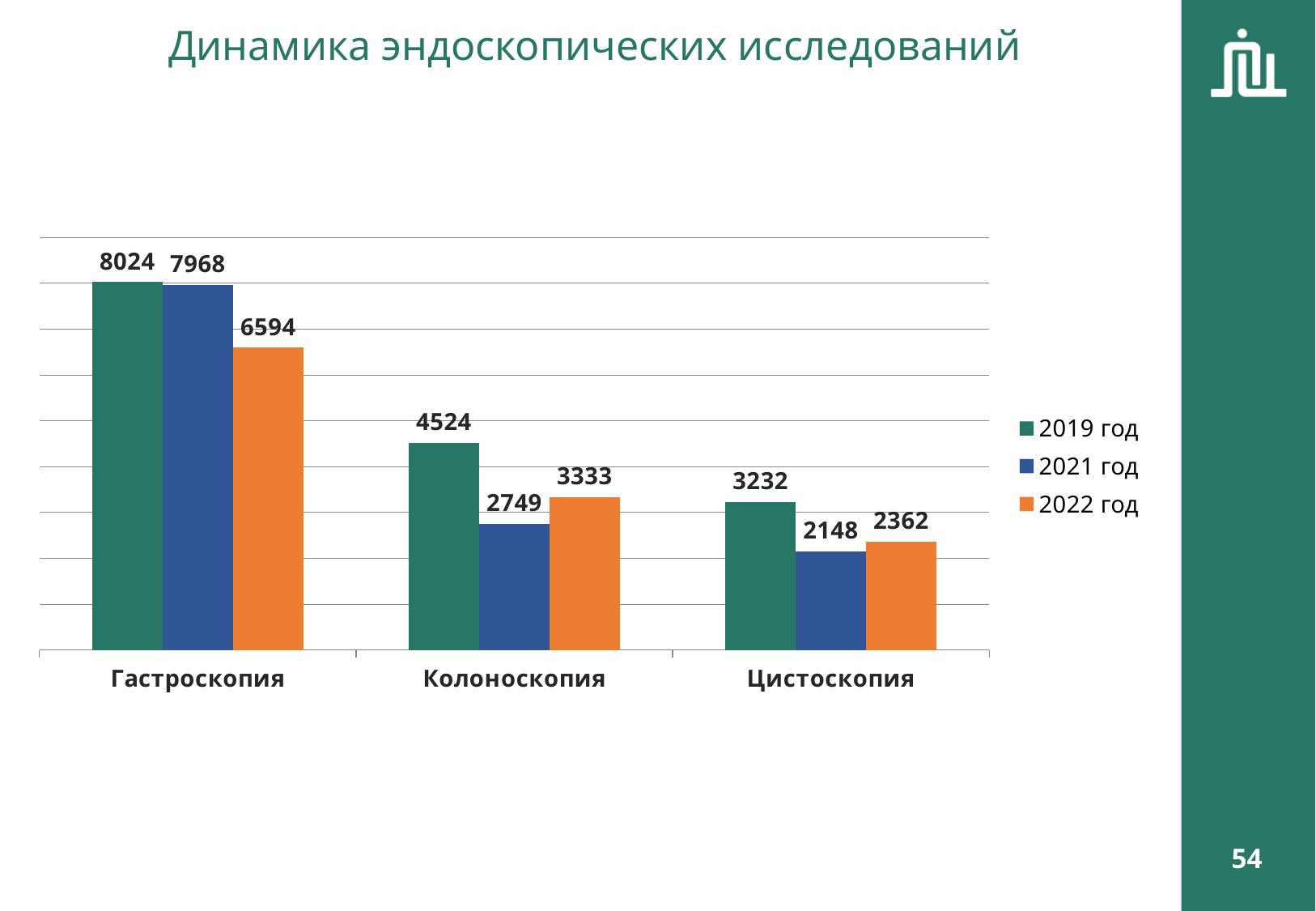
What is the difference between the 2019 год and 2022 год values for Гастроскопия? 1430 What kind of chart is shown on the slide? Bar chart What is the title of the chart? Динамика эндоскопических исследований What is the difference between the 2022 год and 2021 год values for Колоноскопия? 584 Which category has the lowest value in 2022 год? Цистоскопия How many series does the legend list? 3 How many categories are shown on the x axis? 3 Which is larger for Цистоскопия: the 2021 год value or the 2022 год value? 2022 год Which category has the highest value in 2019 год? Гастроскопия What is the value for Цистоскопия in 2021 год? 2148 What is the value for Гастроскопия in 2019 год? 8024 What is the value for Колоноскопия in 2022 год? 3333